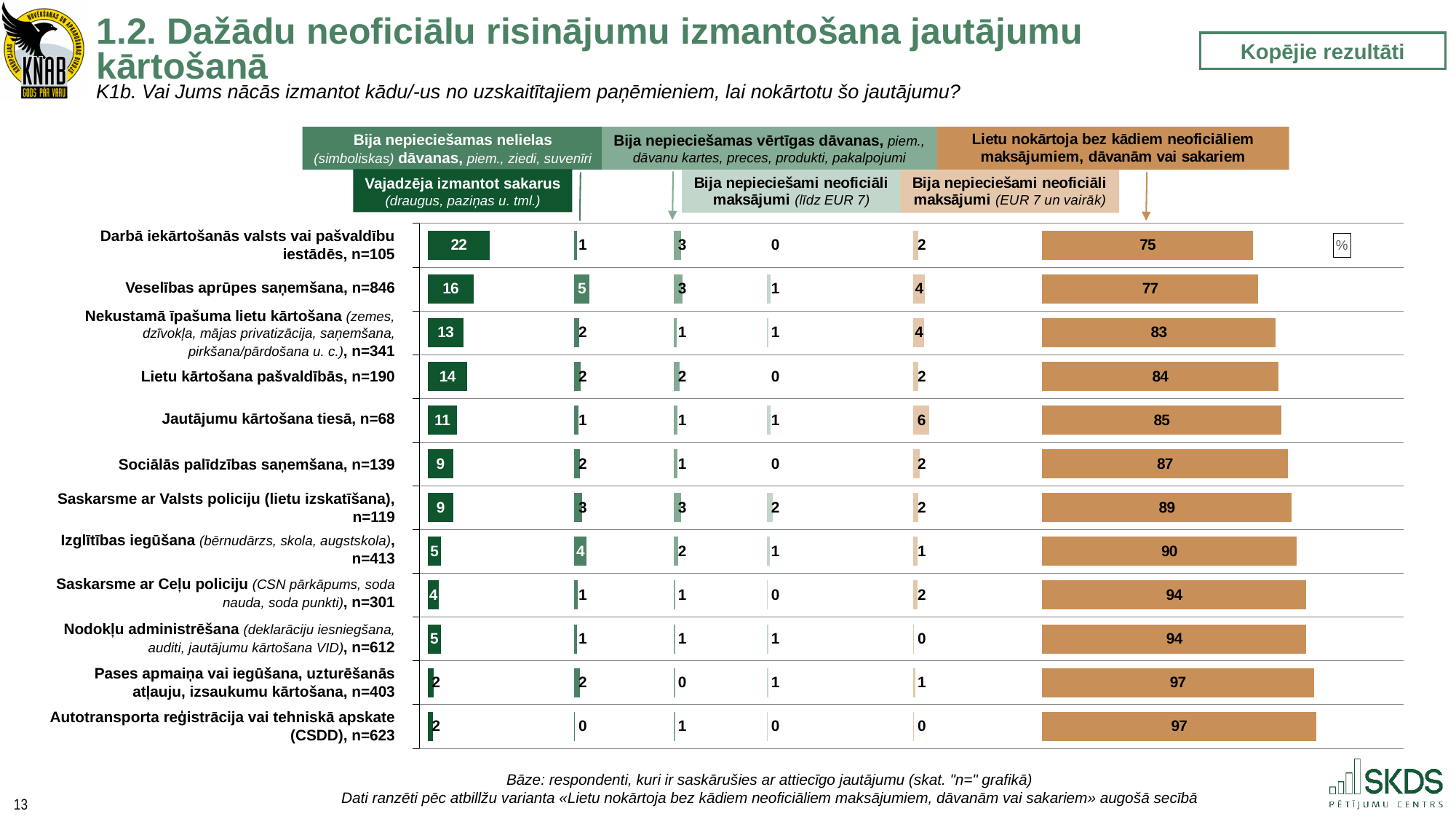
What is the value for 'Lietu nokārtoja bez kādiem neoficiāliem maksājumiem, dāvanām vai sakariem' for 'Veselības aprūpes saņemšana, n=846'? 77 What is the value for 'Vajadzēja izmantot sakarus' for 'Darbā iekārtošanās valsts vai pašvaldību iestādēs, n=105'? 22 What is the difference between the 'Lietu nokārtoja bez kādiem neoficiāliem maksājumiem, dāvanām vai sakariem' values for 'Autotransporta reģistrācija vai tehniskā apskate (CSDD), n=623' and 'Darbā iekārtošanās valsts vai pašvaldību iestādēs, n=105'? 22 What kind of chart is shown on the slide? Bar chart Does the 'Lietu nokārtoja bez kādiem neoficiāliem maksājumiem, dāvanām vai sakariem' value rise or fall going down the list of categories from top to bottom? Rise How many series does the chart's legend list? 6 How many categories (issue types) are listed on the chart? 12 What colour are the bars for 'Lietu nokārtoja bez kādiem neoficiāliem maksājumiem, dāvanām vai sakariem'? Brown Which category has the lowest value for 'Lietu nokārtoja bez kādiem neoficiāliem maksājumiem, dāvanām vai sakariem'? Darbā iekārtošanās valsts vai pašvaldību iestādēs, n=105 What is the value for 'Bija nepieciešami neoficiāli maksājumi (EUR 7 un vairāk)' for 'Jautājumu kārtošana tiesā, n=68'? 6 Which category has the highest value for 'Vajadzēja izmantot sakarus'? Darbā iekārtošanās valsts vai pašvaldību iestādēs, n=105 Which is larger: the 'Vajadzēja izmantot sakarus' value for 'Veselības aprūpes saņemšana, n=846' or for 'Lietu kārtošana pašvaldībās, n=190'? Veselības aprūpes saņemšana, n=846